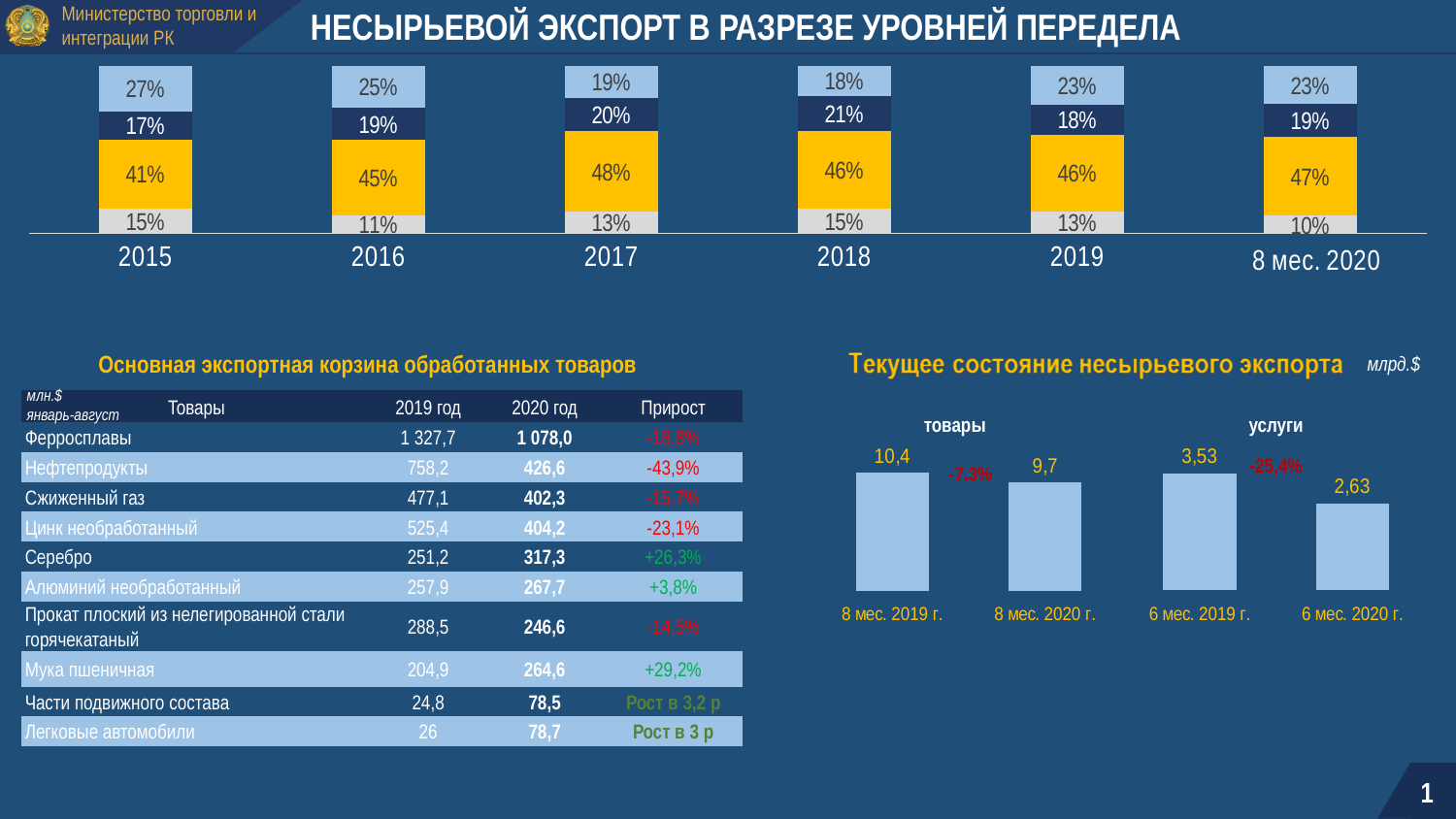
In the top stacked bar chart, what is the value of the topmost light-blue segment for 2015? 27% In the chart 'Текущее состояние несырьевого экспорта', what is the value for товары in 8 мес. 2020 г.? 9,7 What type of chart is 'Текущее состояние несырьевого экспорта'? Bar chart In the chart 'Текущее состояние несырьевого экспорта', which is larger: товары in 8 мес. 2019 г. or товары in 8 мес. 2020 г.? 8 мес. 2019 г. In the top stacked bar chart, how many bars (time periods) are shown? 6 In the chart 'Текущее состояние несырьевого экспорта', what is the value for услуги in 6 мес. 2019 г.? 3,53 In the top stacked bar chart, what is the difference between the yellow segment values for 2016 and 2015? 4% In the top stacked bar chart, what is the value of the yellow segment for 2017? 48% In the top stacked bar chart, what is the total of the four segments for 2018? 100% In the chart 'Текущее состояние несырьевого экспорта', what percentage change is shown for услуги? -25,4% In the top stacked bar chart, which year has the largest yellow segment? 2017 In the top stacked bar chart, what is the value of the bottom grey segment for 8 мес. 2020? 10%